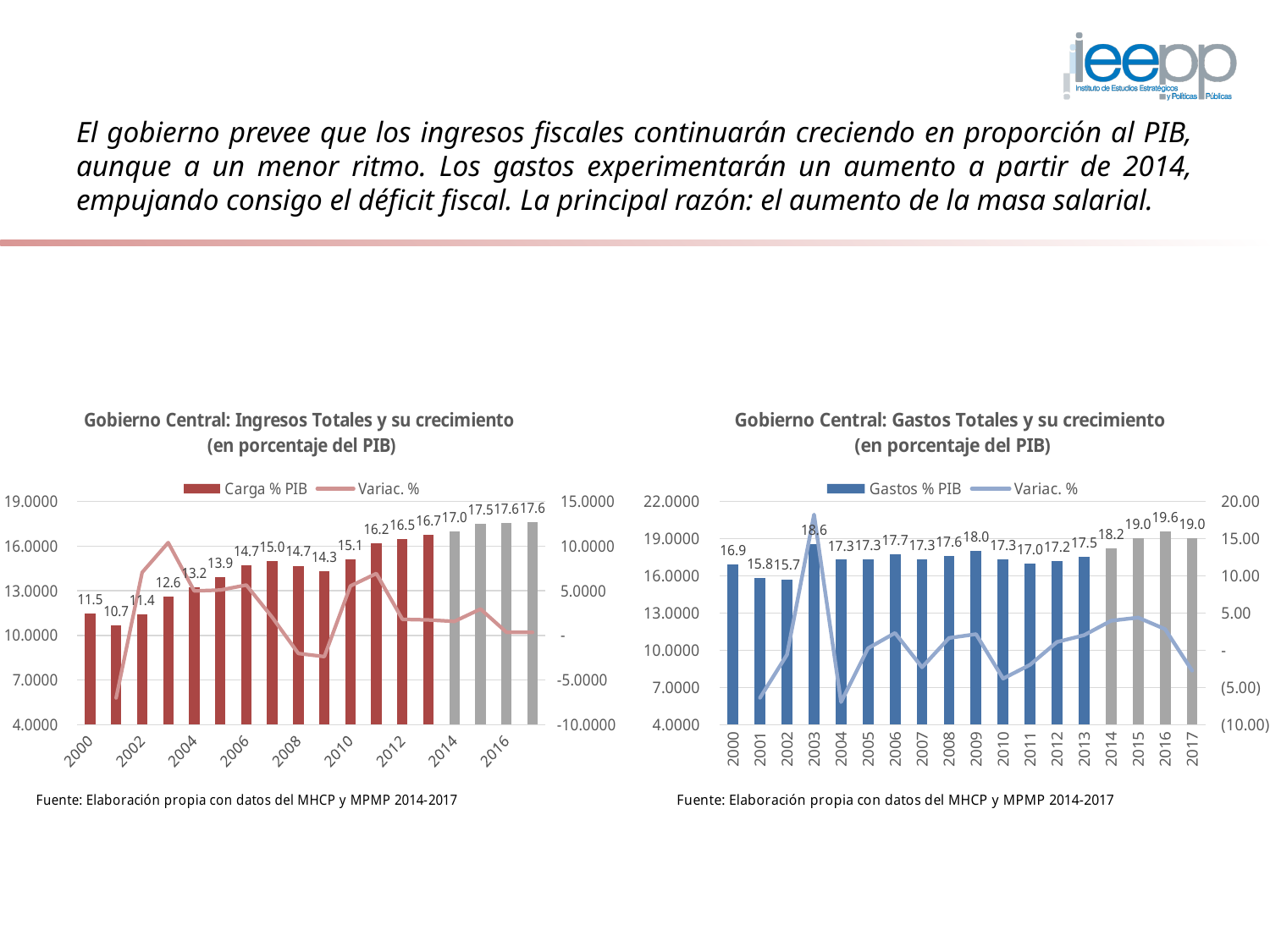
In the chart 'Gobierno Central: Gastos Totales y su crecimiento', which year has the lowest Gastos % PIB bar? 2002 In the chart 'Gobierno Central: Ingresos Totales y su crecimiento', do the Carga % PIB bars rise or fall from 2010 to 2017? rise In the chart 'Gobierno Central: Ingresos Totales y su crecimiento', which year has the lowest Carga % PIB bar? 2001 What kind of chart is 'Gobierno Central: Gastos Totales y su crecimiento'? Combined bar and line chart In the chart 'Gobierno Central: Gastos Totales y su crecimiento', how many years are shown on the x axis? 18 In the chart 'Gobierno Central: Ingresos Totales y su crecimiento', what is the Carga % PIB value for 2000? 11.5 In the chart 'Gobierno Central: Gastos Totales y su crecimiento', what is the Gastos % PIB value for 2003? 18.6 In the chart 'Gobierno Central: Gastos Totales y su crecimiento', which year has the highest Gastos % PIB bar? 2016 In the chart 'Gobierno Central: Gastos Totales y su crecimiento', which is larger, the Gastos % PIB value for 2000 or for 2001? 2000 In the chart 'Gobierno Central: Ingresos Totales y su crecimiento', what is the difference between the Carga % PIB values for 2017 and 2000? 6.1 In the chart 'Gobierno Central: Ingresos Totales y su crecimiento', what are the two legend entries? Carga % PIB and Variac. % In the chart 'Gobierno Central: Ingresos Totales y su crecimiento', how many series does the legend list? 2